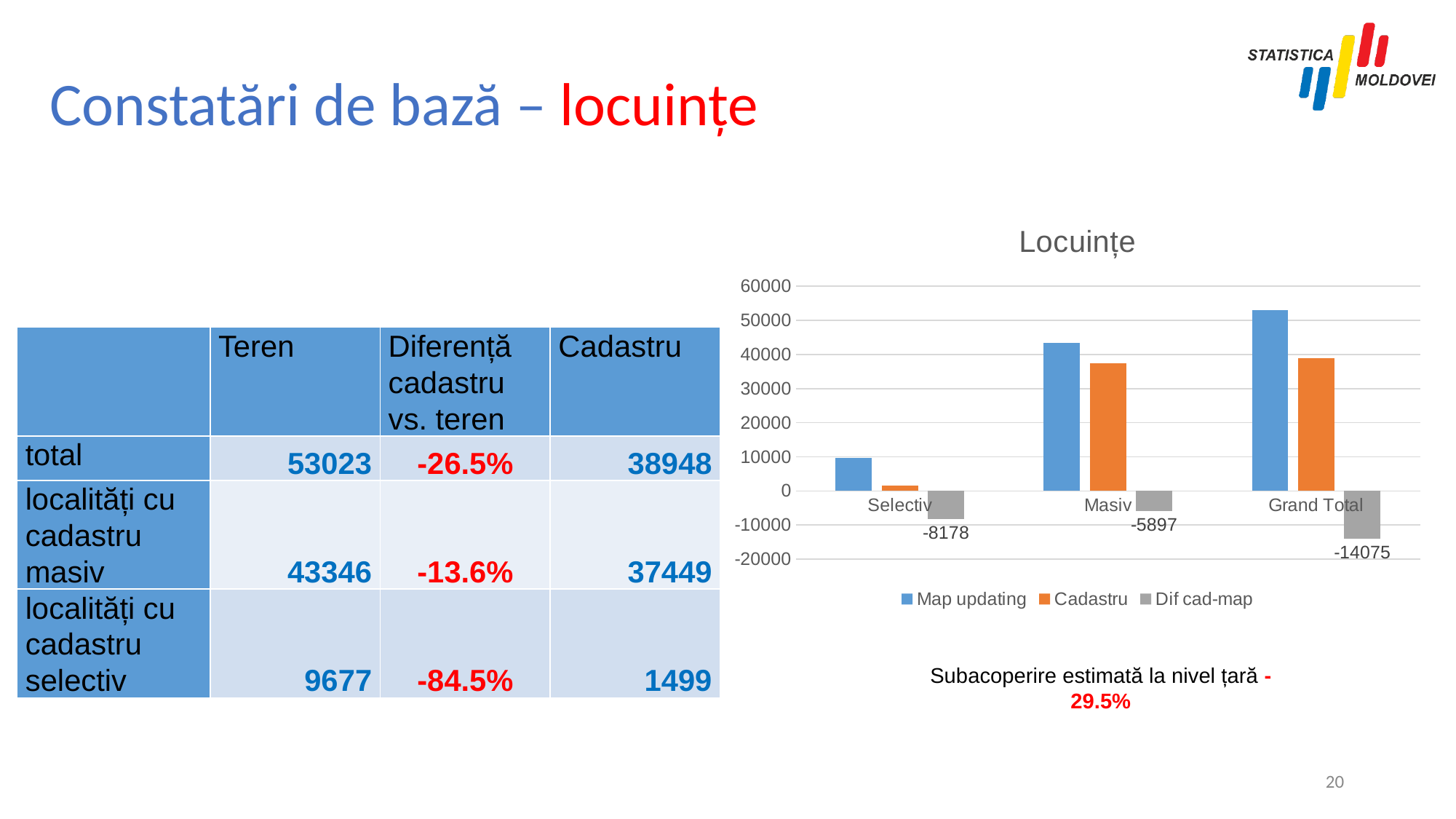
In the "Locuințe" chart, which category has the lowest Dif cad-map value? Grand Total In the "Locuințe" chart, what is the value of Dif cad-map for Selectiv? -8178 In the "Locuințe" chart, is the Cadastru value for Selectiv greater or less than 10000? less How many series does the legend of the "Locuințe" chart list? 3 In the "Locuințe" chart, which is larger for Masiv: Map updating or Cadastru? Map updating In the "Locuințe" chart, is the Map updating value for Grand Total greater or less than 50000? greater How many categories are shown on the x axis of the "Locuințe" chart? 3 In the "Locuințe" chart, which series is shown in orange? Cadastru In the "Locuințe" chart, what is the value of Dif cad-map for Grand Total? -14075 In the "Locuințe" chart, what is the value of Dif cad-map for Masiv? -5897 What kind of chart is shown under the title "Locuințe"? bar chart In the "Locuințe" chart, what is the difference between the Dif cad-map values for Selectiv and Masiv? 2281